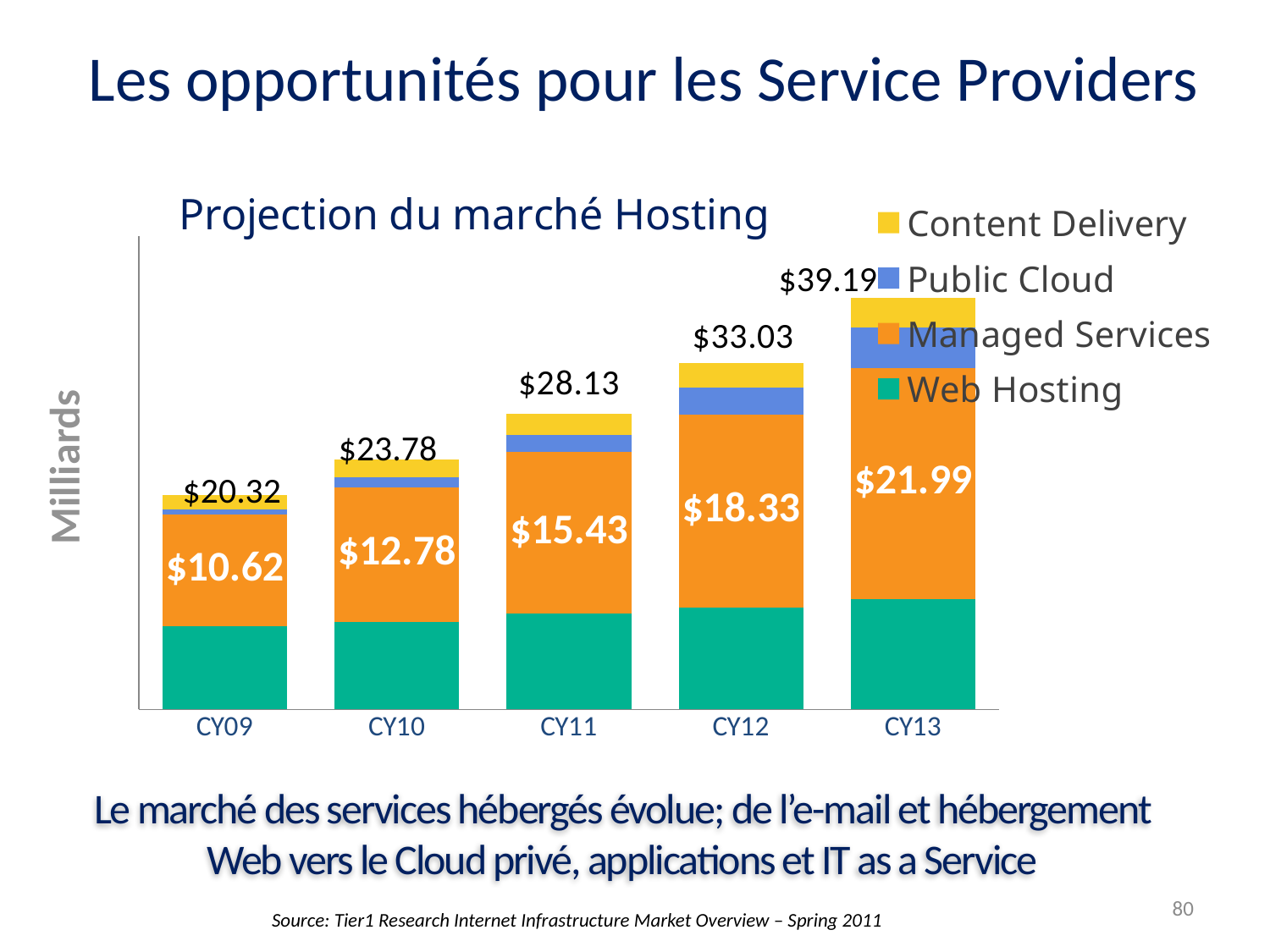
What is the Managed Services value for CY12? $18.33 What is the total value of the stacked bar for CY13? $39.19 How many series does the legend list? 4 What is the difference between the Managed Services value for CY13 and for CY09? $11.37 What is the Managed Services value for CY11? $15.43 Which is larger, the total for CY10 or the total for CY11? CY11 Which year has the lowest total hosting market value? CY09 What is the total value of the stacked bar for CY09? $20.32 Which year has the highest total hosting market value? CY13 How many years are shown on the x axis? 5 Do the total values rise or fall from CY09 to CY13? rise What is the difference between the total for CY13 and the total for CY09? $18.87